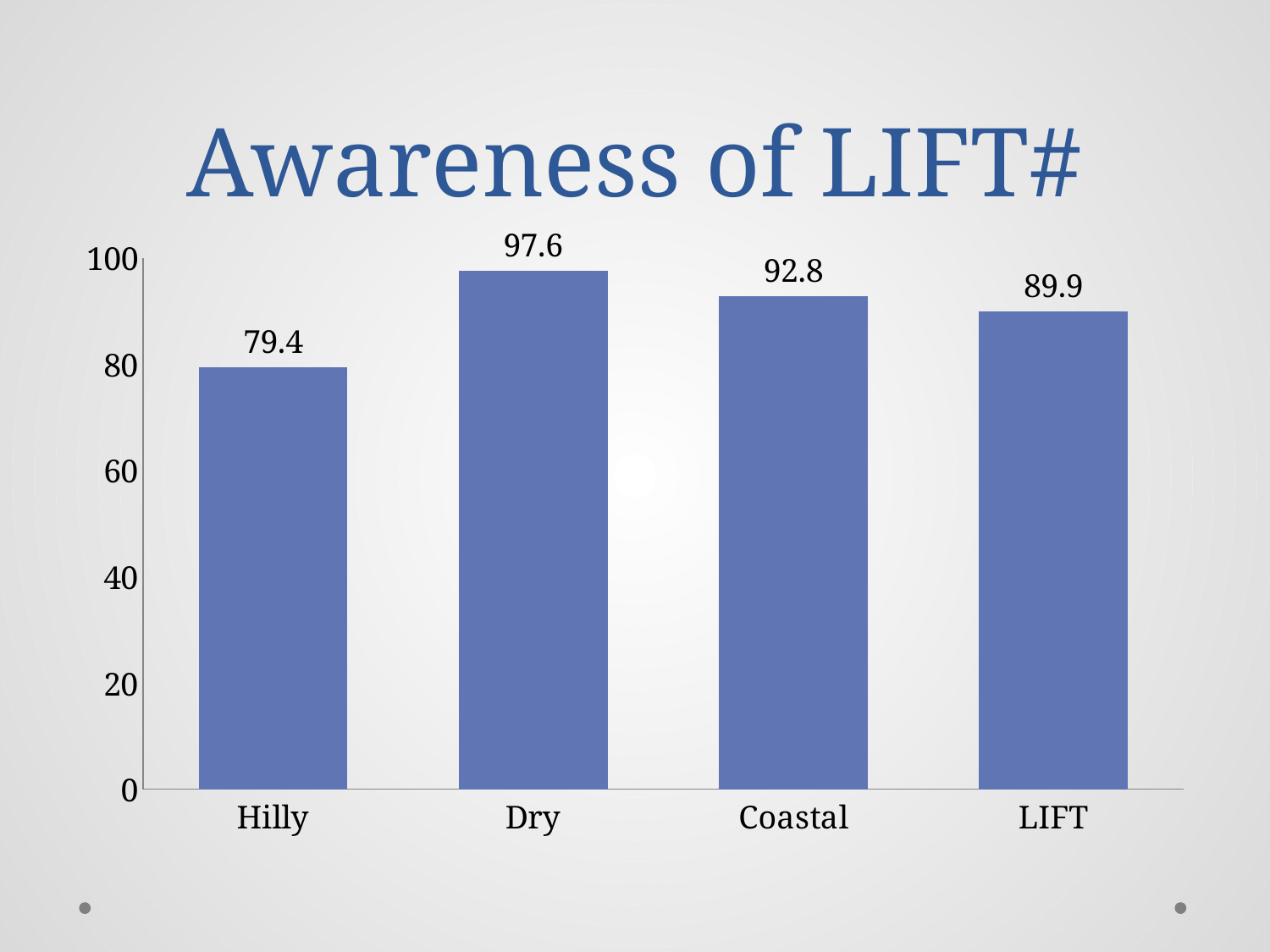
What is the value for Dry? 97.6 Which is larger, the value for Coastal or the value for LIFT? Coastal Is the value for Hilly greater or less than 80? less What is the value for Coastal? 92.8 Which category has the highest value? Dry What is the value for Hilly? 79.4 What kind of chart is shown on the slide? bar chart Which category has the lowest value? Hilly What is the difference between the values for Coastal and LIFT? 2.9 How many categories are shown on the x axis? 4 What is the difference between the values for Dry and Hilly? 18.2 What is the value for LIFT? 89.9